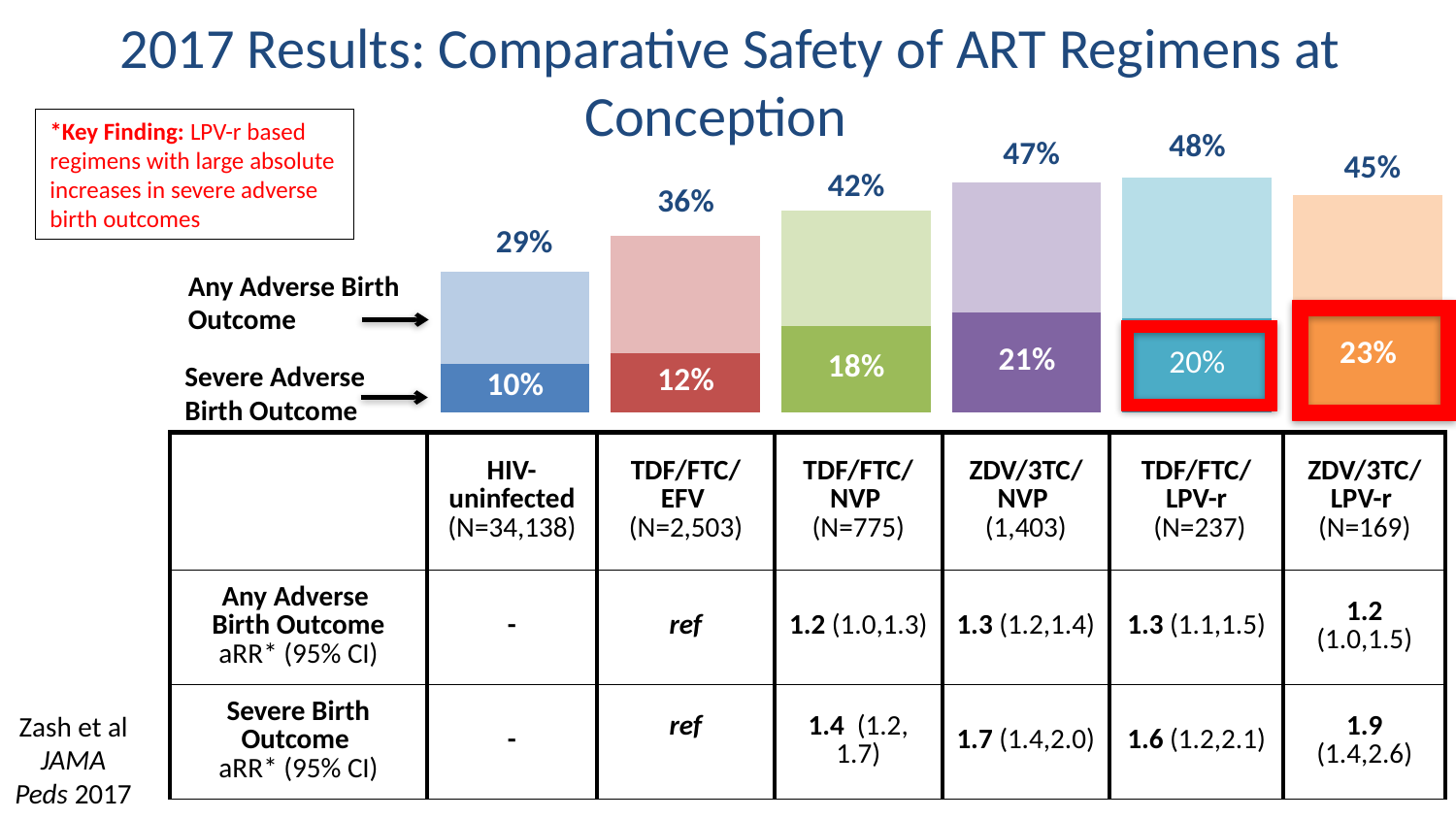
Which group has the lowest Severe Adverse Birth Outcome percentage? HIV-uninfected How many regimen groups are shown in the chart? 6 Does the Any Adverse Birth Outcome percentage rise or fall from HIV-uninfected to TDF/FTC/LPV-r? Rise What kind of chart is shown on the slide? Bar chart Which has a higher Severe Adverse Birth Outcome percentage, ZDV/3TC/NVP or TDF/FTC/LPV-r? ZDV/3TC/NVP Which two groups' Severe Adverse Birth Outcome bars are outlined in red on the chart? TDF/FTC/LPV-r and ZDV/3TC/LPV-r What is the difference between the Any Adverse Birth Outcome percentages for ZDV/3TC/NVP and HIV-uninfected? 18% What is the difference between the Severe Adverse Birth Outcome percentages for ZDV/3TC/LPV-r and TDF/FTC/EFV? 11% What is the Severe Adverse Birth Outcome percentage for the ZDV/3TC/LPV-r group? 23% What is the Any Adverse Birth Outcome percentage for the TDF/FTC/EFV group? 36% What is the Severe Adverse Birth Outcome percentage for the HIV-uninfected group? 10% Which group has the highest Any Adverse Birth Outcome percentage? TDF/FTC/LPV-r